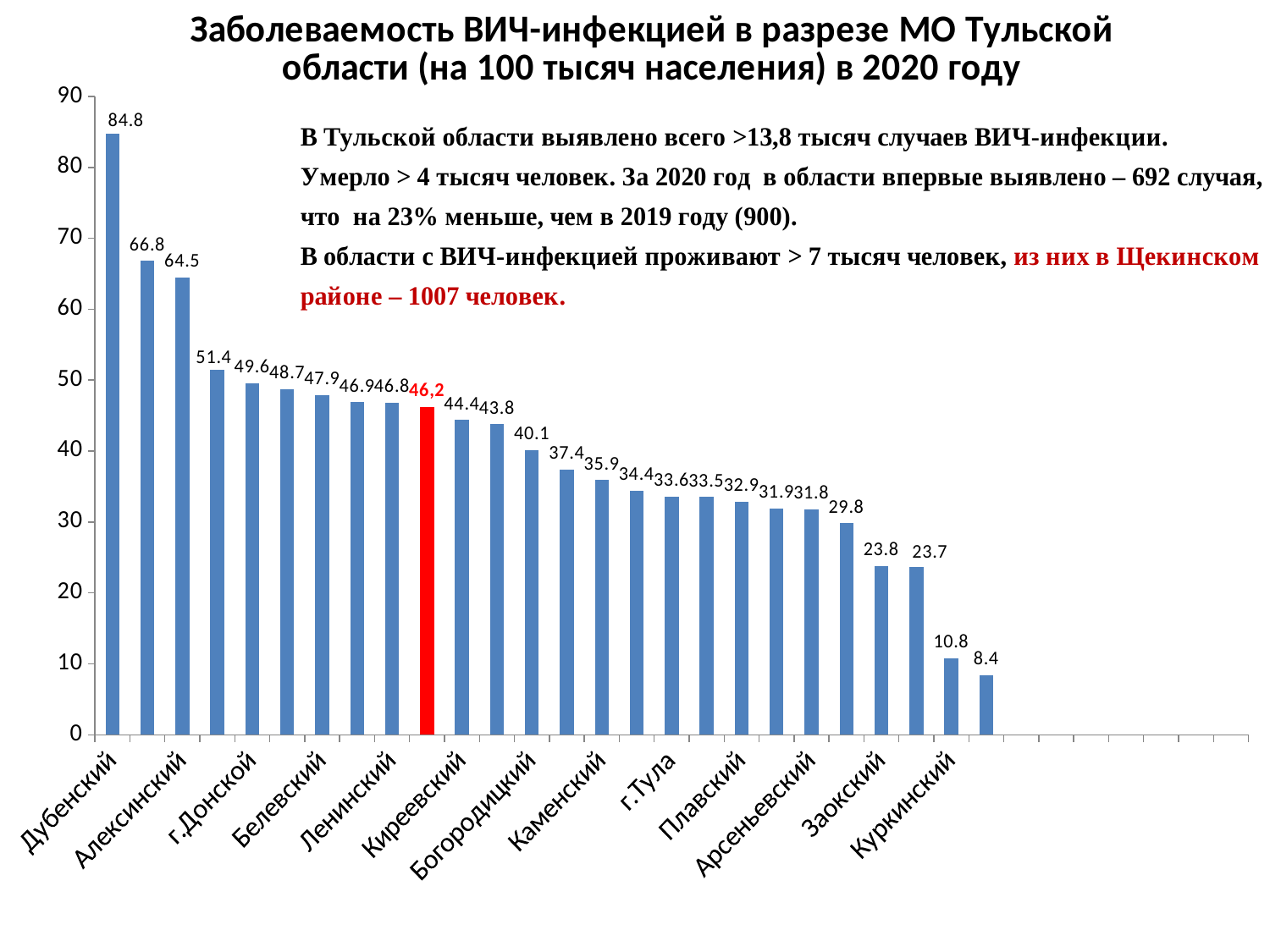
Do the values rise or fall from left to right along the x axis? fall What kind of chart is shown on the slide? bar chart What is the value for Алексинский? 64.5 What is the value of the lowest bar in the chart? 8.4 What is the value for г.Тула? 33.6 What is the difference between the values for Дубенский and Алексинский? 20.3 What is the value for Заокский? 23.8 What is the value for Дубенский? 84.8 Which is larger, the value for Белевский or the value for Ленинский? Белевский What value is labelled on the red bar? 46,2 Which category has the highest value? Дубенский What is the value for Куркинский? 10.8